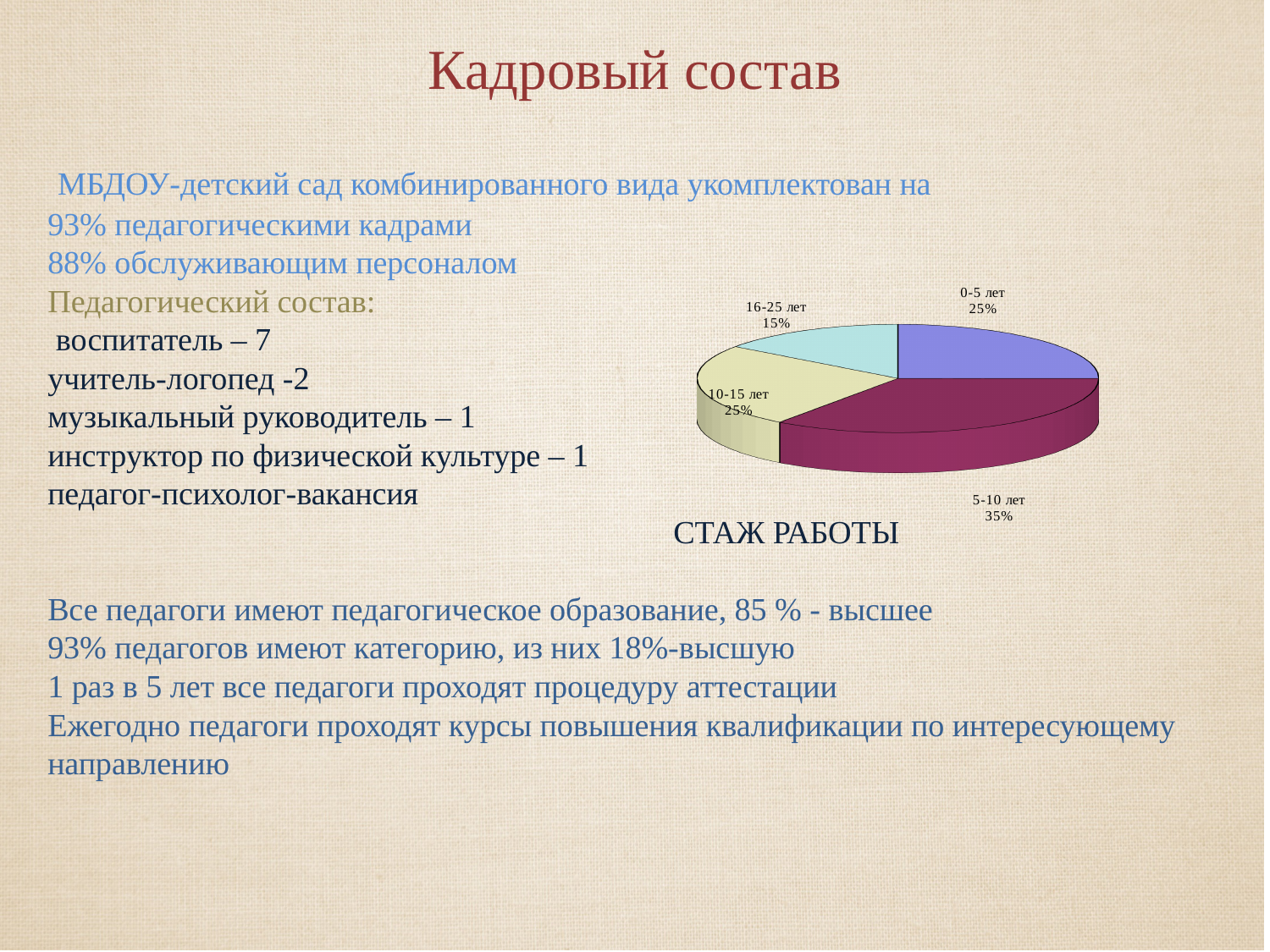
What is the difference between the 5-10 лет slice and the 16-25 лет slice? 20% What percentage is shown for the 16-25 лет slice? 15% What is the title of the chart? СТАЖ РАБОТЫ Which is larger, the 5-10 лет slice or the 0-5 лет slice? 5-10 лет Which category has the largest slice of the pie? 5-10 лет Which category has the smallest slice of the pie? 16-25 лет What kind of chart is shown on the slide? pie chart What percentage is shown for the 0-5 лет slice? 25% What percentage is shown for the 5-10 лет slice? 35% How many slices does the pie chart have? 4 What colour is the 5-10 лет slice? magenta (purple-red) What percentage is shown for the 10-15 лет slice? 25%